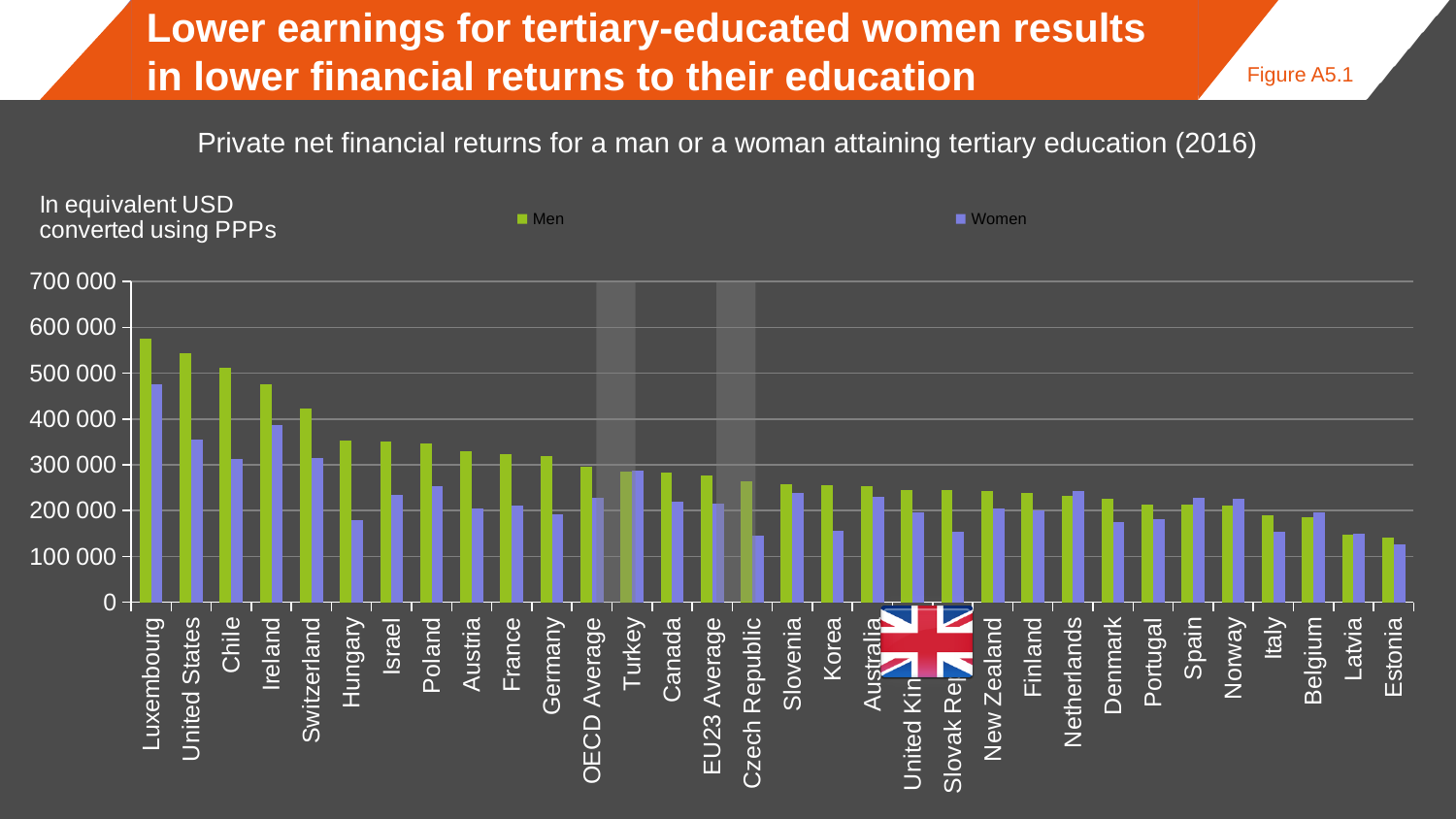
Which country has the highest value for Women? Luxembourg What are the two series named in the legend? Men and Women Is the Men value for Switzerland greater or less than 400 000? greater What kind of chart is shown on the slide? bar chart What is the title of the chart? Private net financial returns for a man or a woman attaining tertiary education (2016) In Hungary, which is larger, the value for Men or the value for Women? Men Is the Women value for Luxembourg greater or less than 500 000? less How many series does the legend list? 2 Which country has the highest value for Men? Luxembourg Is the Women value for Hungary greater or less than 200 000? less Do the Men values generally rise or fall moving from left to right along the x axis? fall